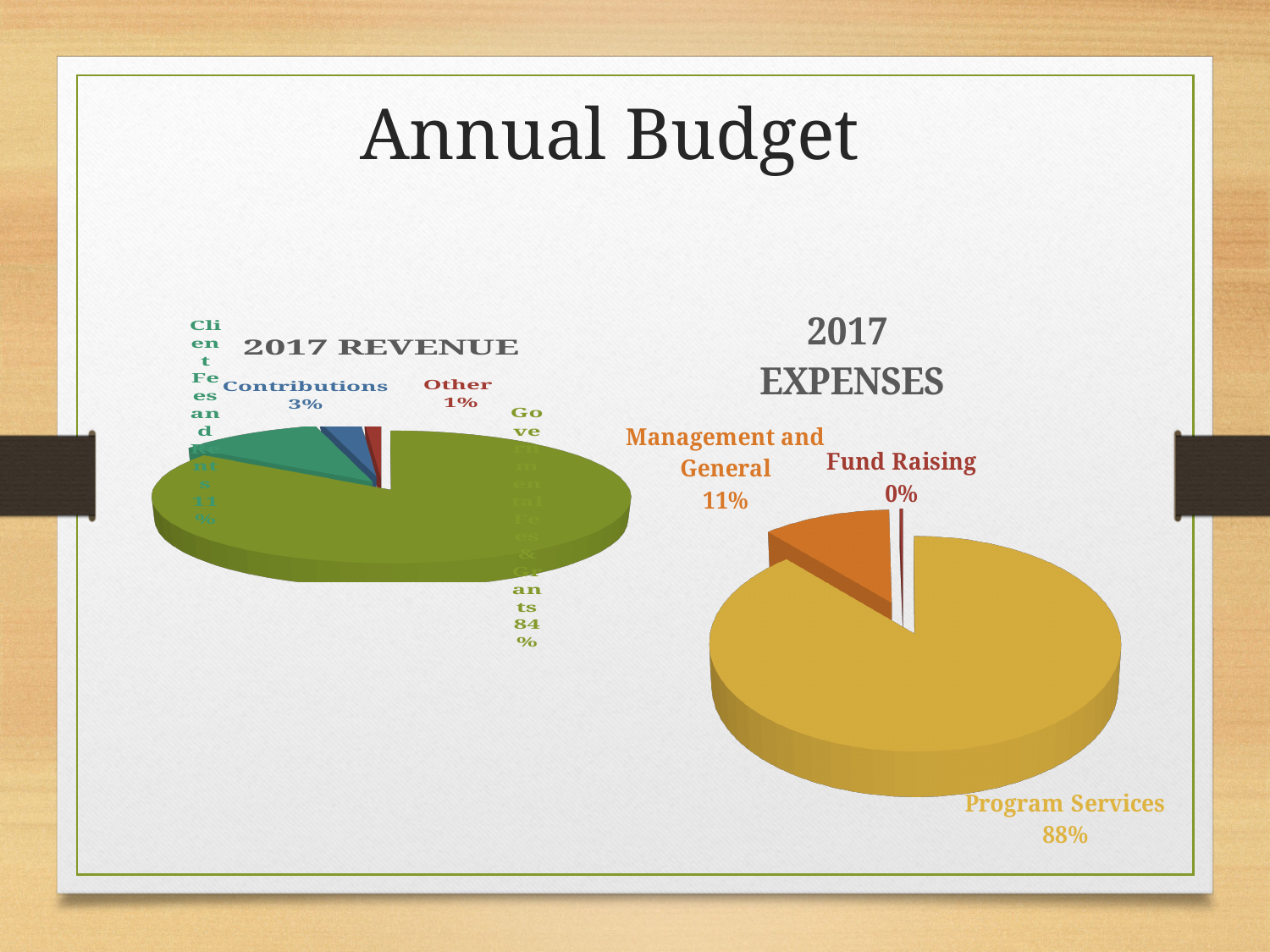
In the 2017 EXPENSES chart, what share of expenses is Management and General? 11% In the 2017 EXPENSES chart, which category has the smallest slice? Fund Raising In the 2017 REVENUE chart, which is larger, Contributions or Other? Contributions In the 2017 REVENUE chart, how many slices does the pie have? 4 In the 2017 EXPENSES chart, how many percentage points larger is Program Services than Management and General? 77 percentage points In the 2017 EXPENSES chart, how many categories are shown? 3 In the 2017 REVENUE chart, what share of revenue is Contributions? 3% In the 2017 REVENUE chart, what share of revenue is Other? 1% In the 2017 EXPENSES chart, which category has the largest slice? Program Services What kind of chart is the 2017 EXPENSES chart? Pie chart